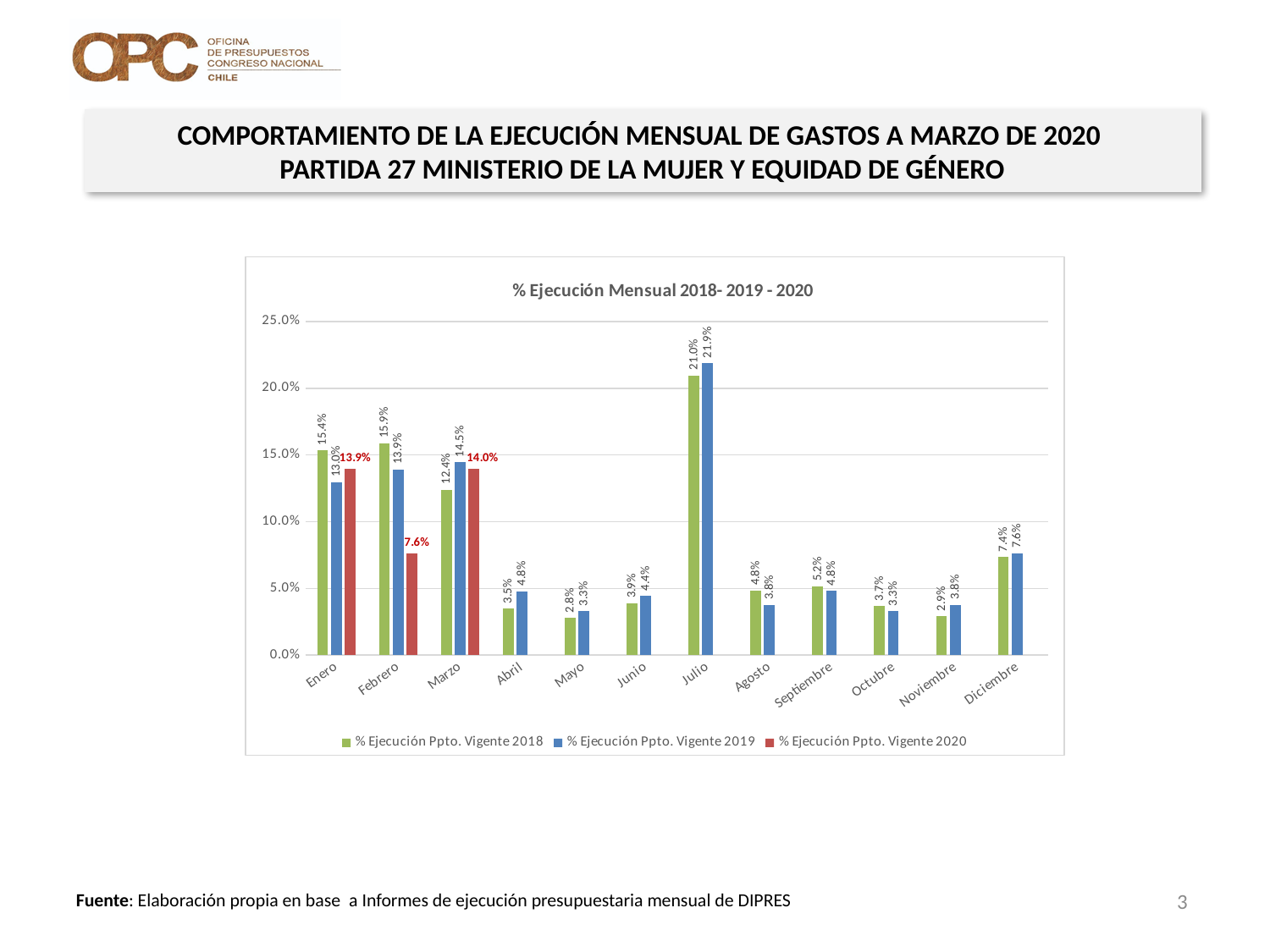
Is the value for % Ejecución Ppto. Vigente 2019 in Diciembre greater or less than 10.0%? less What kind of chart is shown? Bar chart What is the difference between the 2019 and 2018 values in Julio? 0.9% How many months are shown on the x axis? 12 How many series does the legend list? 3 What is the title of the chart? % Ejecución Mensual 2018- 2019 - 2020 What is the value for % Ejecución Ppto. Vigente 2020 in Febrero? 7.6% Which month has the lowest value for % Ejecución Ppto. Vigente 2018? Mayo What is the value for % Ejecución Ppto. Vigente 2018 in Julio? 21.0% Which month has the highest value for % Ejecución Ppto. Vigente 2019? Julio In Enero, which is larger: the 2018 value or the 2019 value? 2018 What is the value for % Ejecución Ppto. Vigente 2019 in Marzo? 14.5%